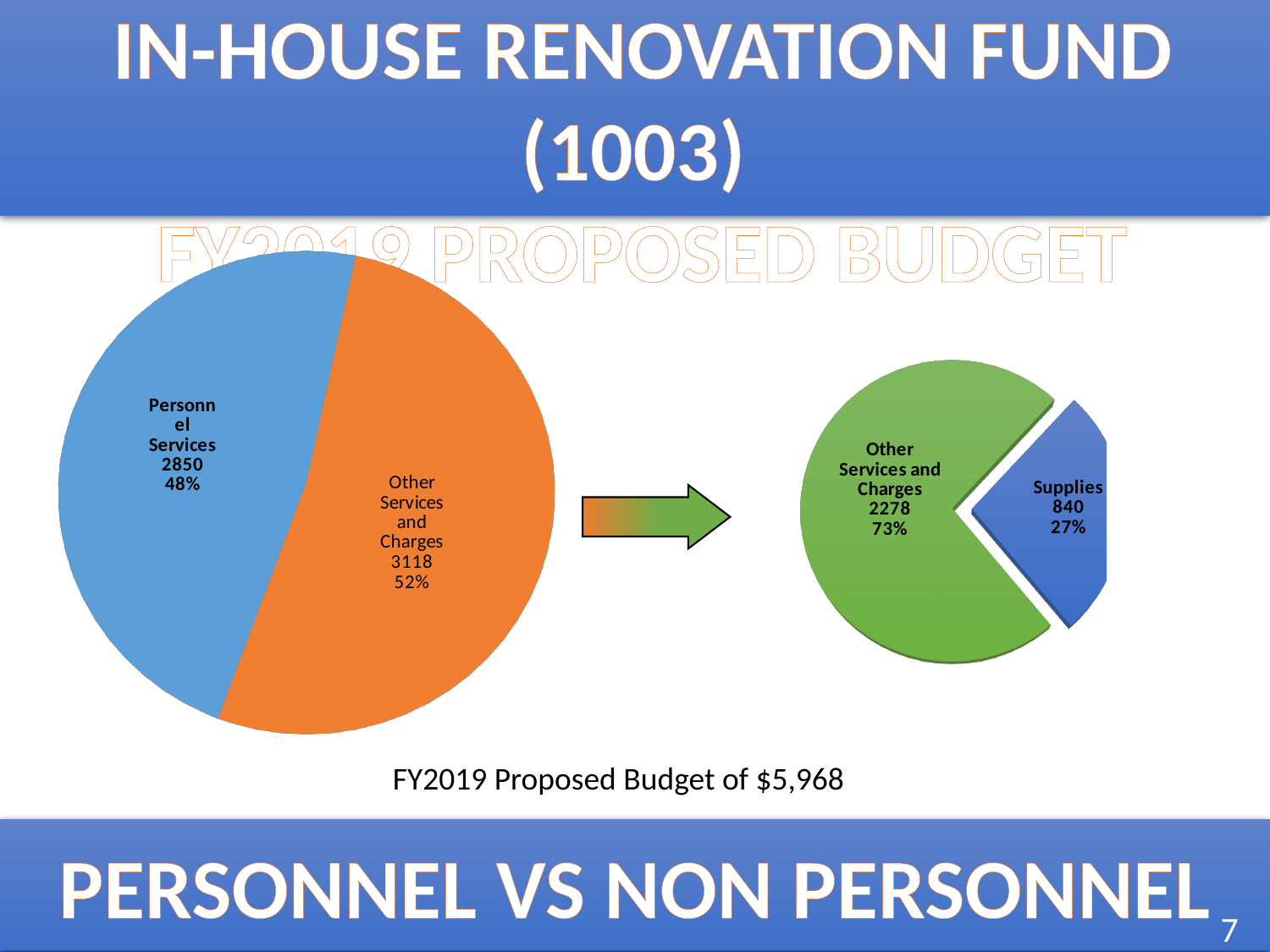
In the left pie chart, what is the value for Other Services and Charges? 3118 In the left pie chart, which slice is larger, Personnel Services or Other Services and Charges? Other Services and Charges In the right pie chart, what is the value for Supplies? 840 In the left pie chart, what is the difference between Other Services and Charges and Personnel Services? 268 In the right pie chart, what share of the pie is Supplies? 27% How many slices does the right pie chart have? 2 What kind of chart is shown on the left of the slide? Pie chart In the right pie chart, what is the difference between Other Services and Charges and Supplies? 1438 In the left pie chart, what share of the pie is Personnel Services? 48% In the right pie chart, which slice is the largest? Other Services and Charges In the left pie chart, what is the value for Personnel Services? 2850 In the right pie chart, what is the value for Other Services and Charges? 2278